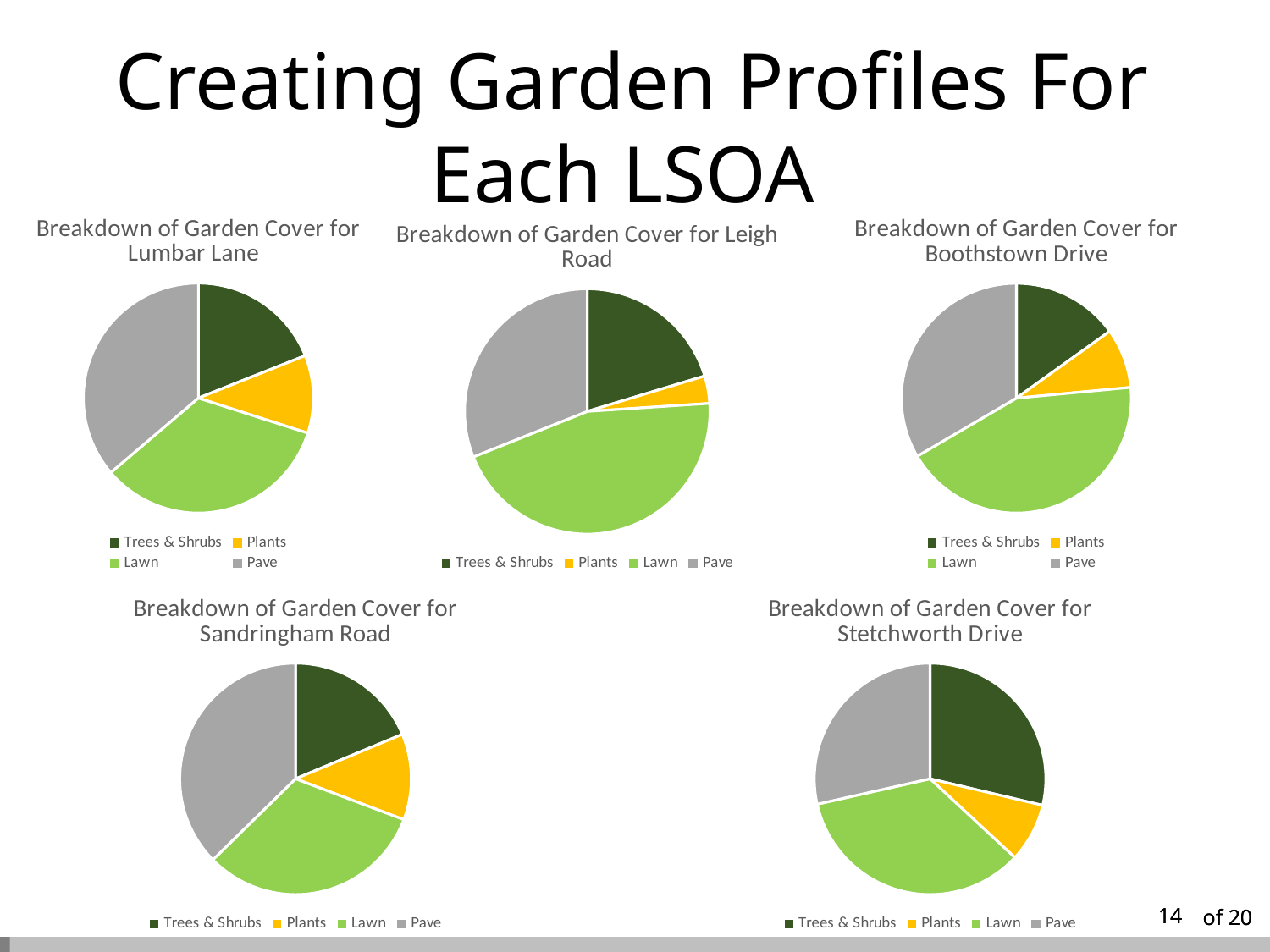
How many categories does the 'Breakdown of Garden Cover for Leigh Road' pie chart show? 4 In the 'Breakdown of Garden Cover for Boothstown Drive' chart, which slice is larger, Lawn or Pave? Lawn In the 'Breakdown of Garden Cover for Sandringham Road' chart, which category has the smallest slice? Plants In the 'Breakdown of Garden Cover for Leigh Road' chart, which category has the smallest slice? Plants How many pie charts are shown on the slide? 5 What kind of chart is 'Breakdown of Garden Cover for Lumbar Lane'? Pie chart In the 'Breakdown of Garden Cover for Stetchworth Drive' chart, which category has the smallest slice? Plants In the 'Breakdown of Garden Cover for Leigh Road' chart, which category has the largest slice? Lawn In the 'Breakdown of Garden Cover for Leigh Road' chart, which slice is larger, Trees & Shrubs or Plants? Trees & Shrubs How many entries does the legend of the 'Breakdown of Garden Cover for Boothstown Drive' chart list? 4 In the 'Breakdown of Garden Cover for Boothstown Drive' chart, which category has the largest slice? Lawn